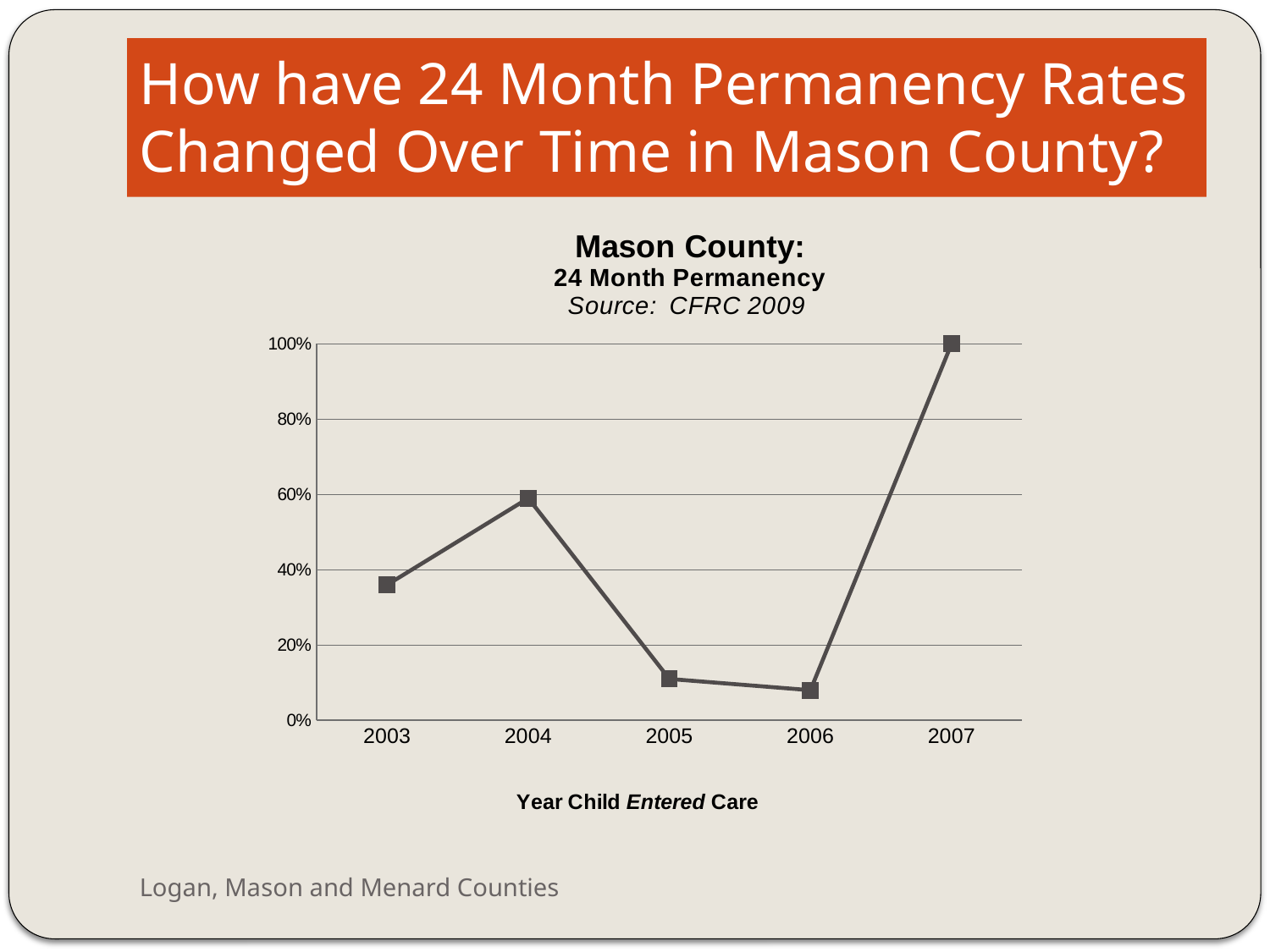
Is the value for 2003 greater or less than 40%? less What is the title of the x axis? Year Child Entered Care Does the permanency rate rise or fall from 2004 to 2005? fall Which year has the highest 24 month permanency rate? 2007 What is the 24 month permanency rate for children who entered care in 2007? 100% What kind of chart is shown on the slide? line chart How many years are plotted on the chart? 5 Which year has the lowest 24 month permanency rate? 2006 Which year has a higher permanency rate, 2003 or 2004? 2004 Does the permanency rate rise or fall from 2006 to 2007? rise Is the value for 2005 greater or less than 20%? less Is the value for 2004 greater or less than 40%? greater